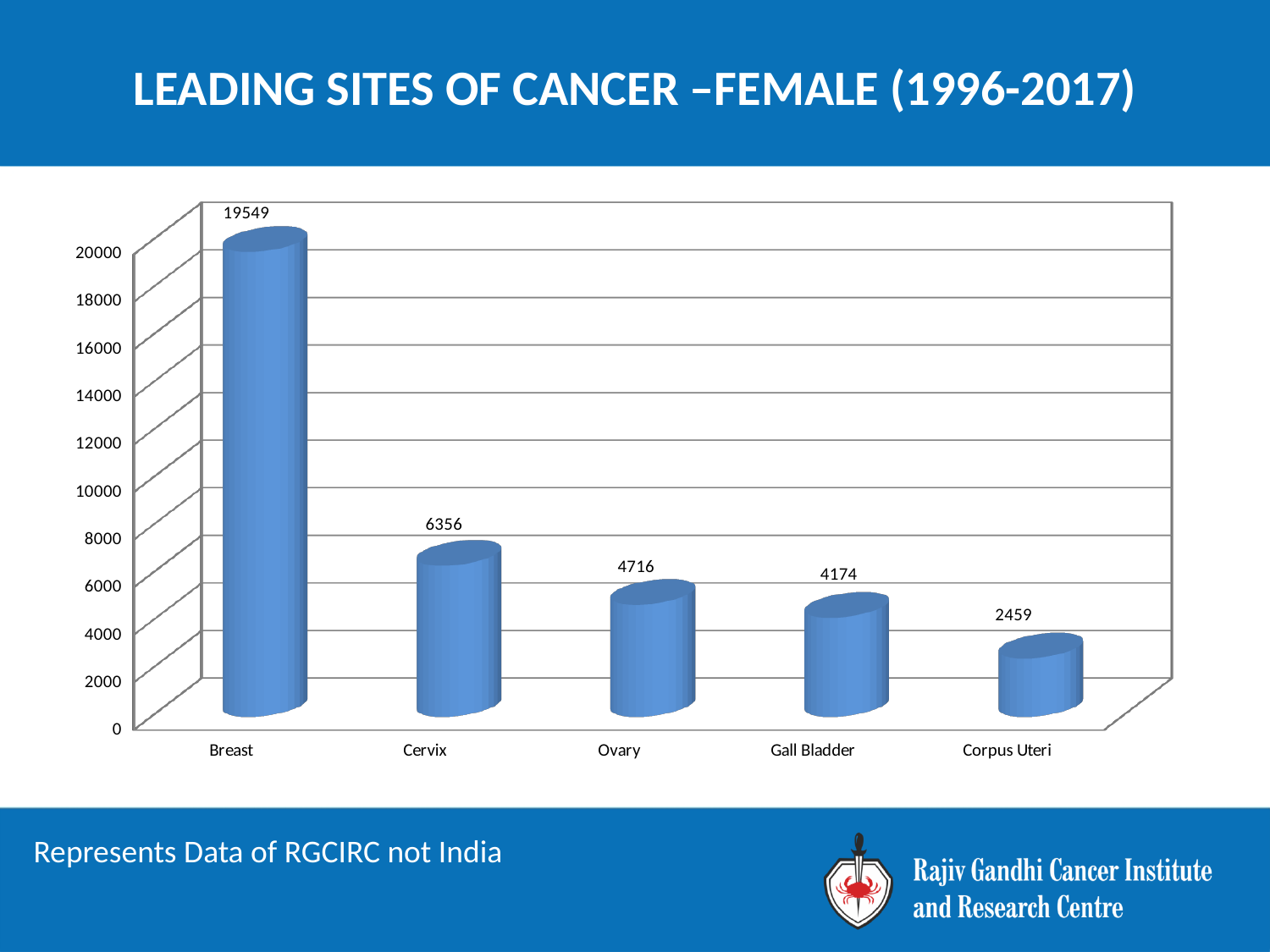
What is the value for Gall Bladder? 4174 What is the value for Corpus Uteri? 2459 Which cancer site has the highest value? Breast What kind of chart is shown on the slide? Bar chart What is the value for Cervix? 6356 What is the difference between the values for Ovary and Gall Bladder? 542 Which cancer site has the lowest value? Corpus Uteri Which is larger, the value for Ovary or the value for Corpus Uteri? Ovary What is the value for Breast? 19549 What is the difference between the values for Breast and Cervix? 13193 How many cancer sites are shown on the chart? 5 Do the values rise or fall from left to right along the x axis? Fall